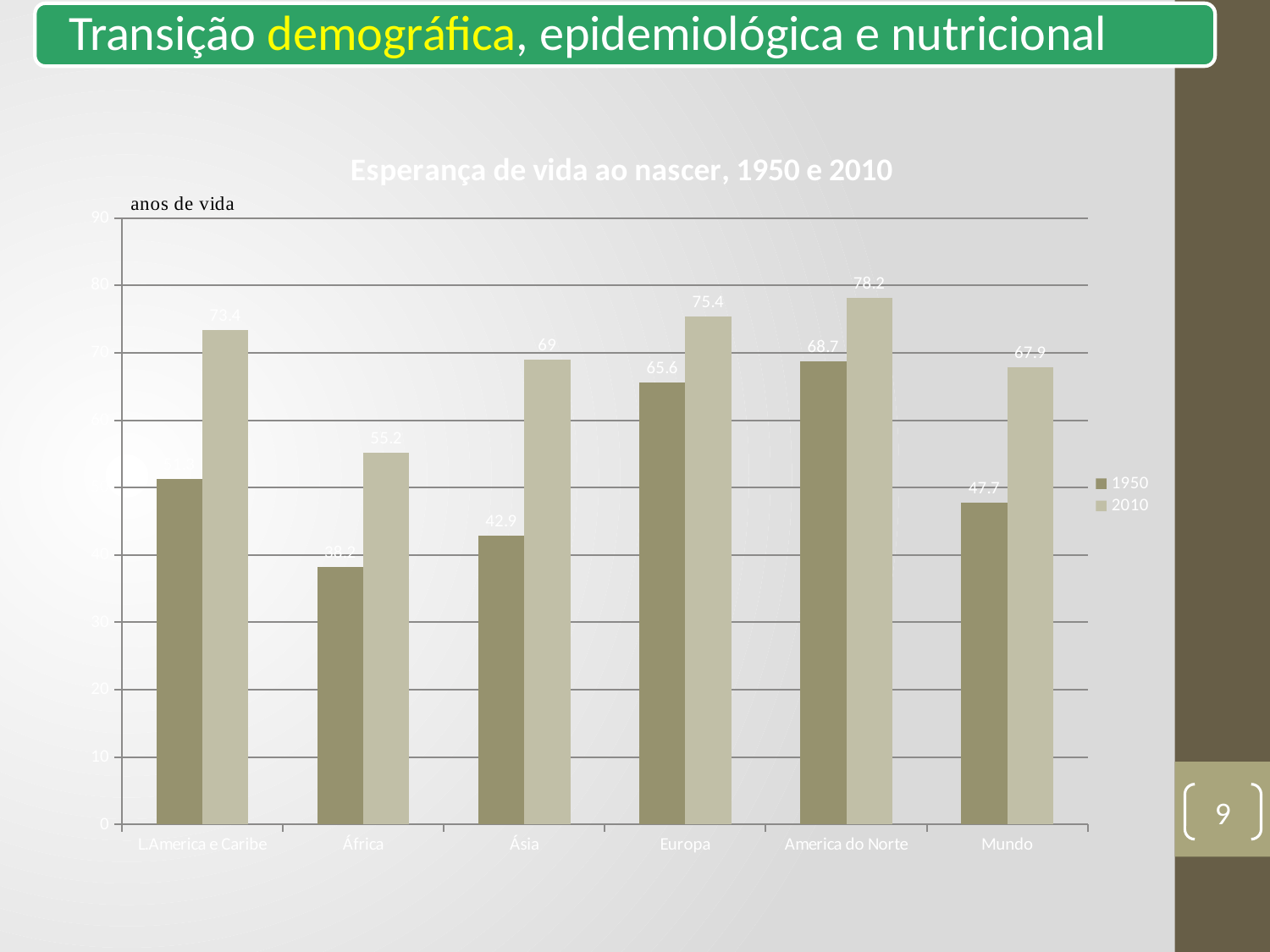
Which is larger in 2010: L.America e Caribe or Europa? Europa Which region has the lowest 2010 value? África Which region has the highest 2010 value? America do Norte How many series does the legend list? 2 By how much did the value for Ásia increase from 1950 to 2010? 26.1 What is the 2010 value shown for Mundo? 67.9 Is the 1950 value for L.America e Caribe greater or less than 60? less What kind of chart is shown on the slide? bar chart What is the title of the chart? Esperança de vida ao nascer, 1950 e 2010 How many regions are shown on the x axis? 6 What is the 2010 life expectancy value shown for Europa? 75.4 What is the 1950 value shown for America do Norte? 68.7